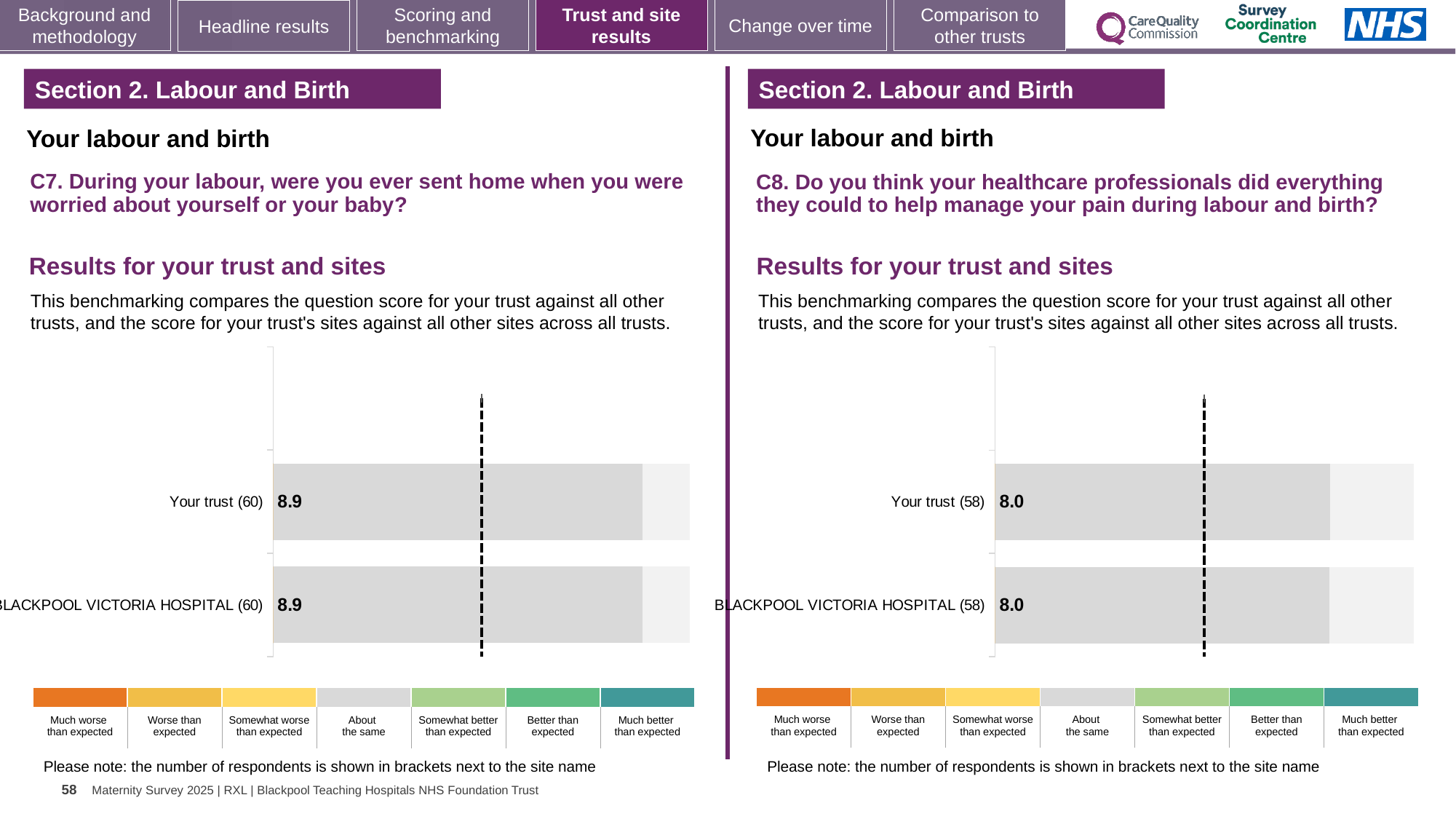
What kind of chart is used on the left (C7) to show the results for your trust and sites? Bar chart On the right chart (C8), what is the score for Your trust? 8.0 On the left chart (C7), what is the score for BLACKPOOL VICTORIA HOSPITAL? 8.9 How many bars are plotted on the left chart (C7)? 2 On the left chart (C7), what is the score for Your trust? 8.9 On the right chart (C8), what is the score for BLACKPOOL VICTORIA HOSPITAL? 8.0 On the left chart (C7), how many respondents are shown in brackets next to Your trust? 60 On the right chart (C8), what is the difference between the score for Your trust and the score for BLACKPOOL VICTORIA HOSPITAL? 0.0 How many bars are plotted on the right chart (C8)? 2 On the left chart (C7), what is the difference between the score for Your trust and the score for BLACKPOOL VICTORIA HOSPITAL? 0.0 On the right chart (C8), how many respondents are shown in brackets next to BLACKPOOL VICTORIA HOSPITAL? 58 Is the score for Your trust on the left chart (C7) larger or smaller than the score for Your trust on the right chart (C8)? Larger